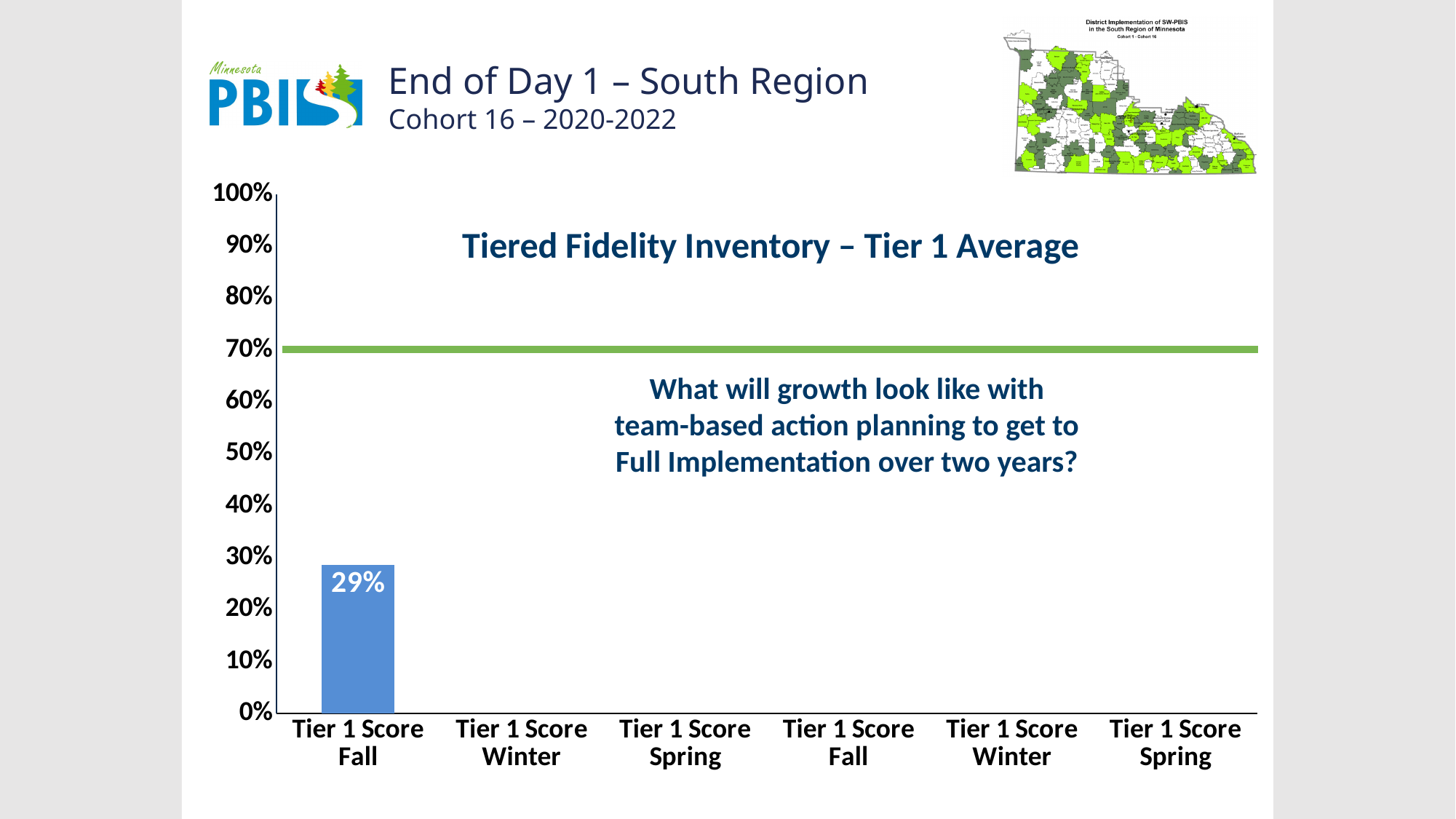
Is the value for the first Tier 1 Score Fall bar greater or less than 30%? less What is the value of the first Tier 1 Score Fall bar? 29% Is the first Tier 1 Score Fall bar above or below the green 70% line? below What kind of chart is shown on the slide? bar chart How many bars have a plotted value in the chart? 1 What is the highest value shown on the y axis? 100% At what level on the y axis is the green horizontal line drawn? 70% Is the value for the first Tier 1 Score Fall bar greater or less than 20%? greater How many categories are labelled along the x axis of the chart? 6 What is the difference between the green line level and the first Tier 1 Score Fall bar value? 41% What is the title of the chart? Tiered Fidelity Inventory – Tier 1 Average